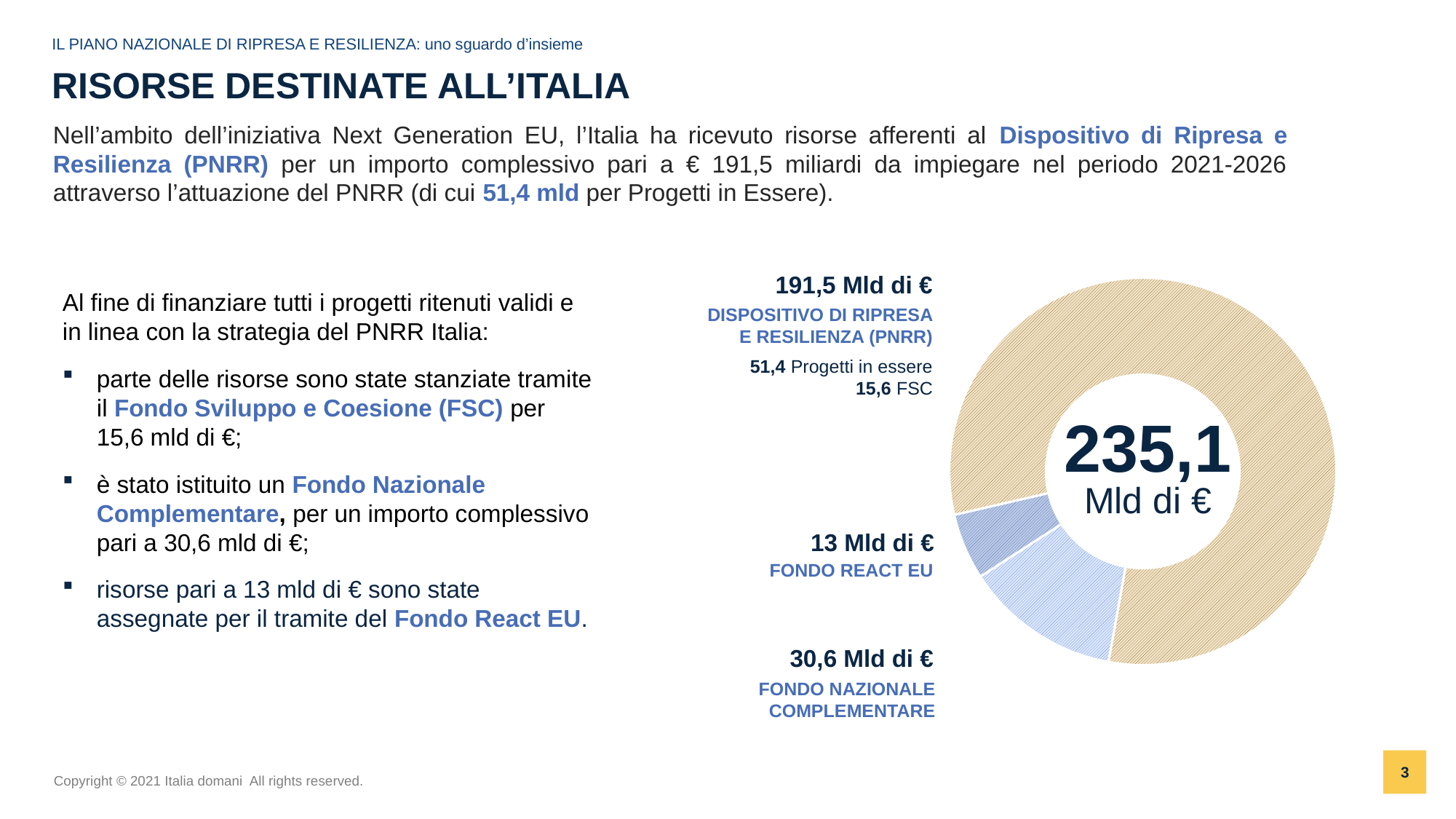
Which is larger, the Fondo Nazionale Complementare segment or the Fondo React EU segment? Fondo Nazionale Complementare What is the value shown for the Fondo Nazionale Complementare segment? 30,6 Mld di € What is the value shown for the Fondo React EU segment? 13 Mld di € Which segment of the donut chart is the smallest? Fondo React EU How many segments does the donut chart have? 3 Which segment of the donut chart is the largest? Dispositivo di Ripresa e Resilienza (PNRR) What is the value shown for the Dispositivo di Ripresa e Resilienza (PNRR) segment? 191,5 Mld di € How much of the PNRR amount is labelled as Progetti in essere? 51,4 How much of the PNRR amount is labelled as FSC? 15,6 What kind of chart is shown on the slide? Donut (pie) chart What total is printed in the centre of the donut chart? 235,1 Mld di € What is the difference between the Fondo Nazionale Complementare value and the Fondo React EU value? 17,6 Mld di €